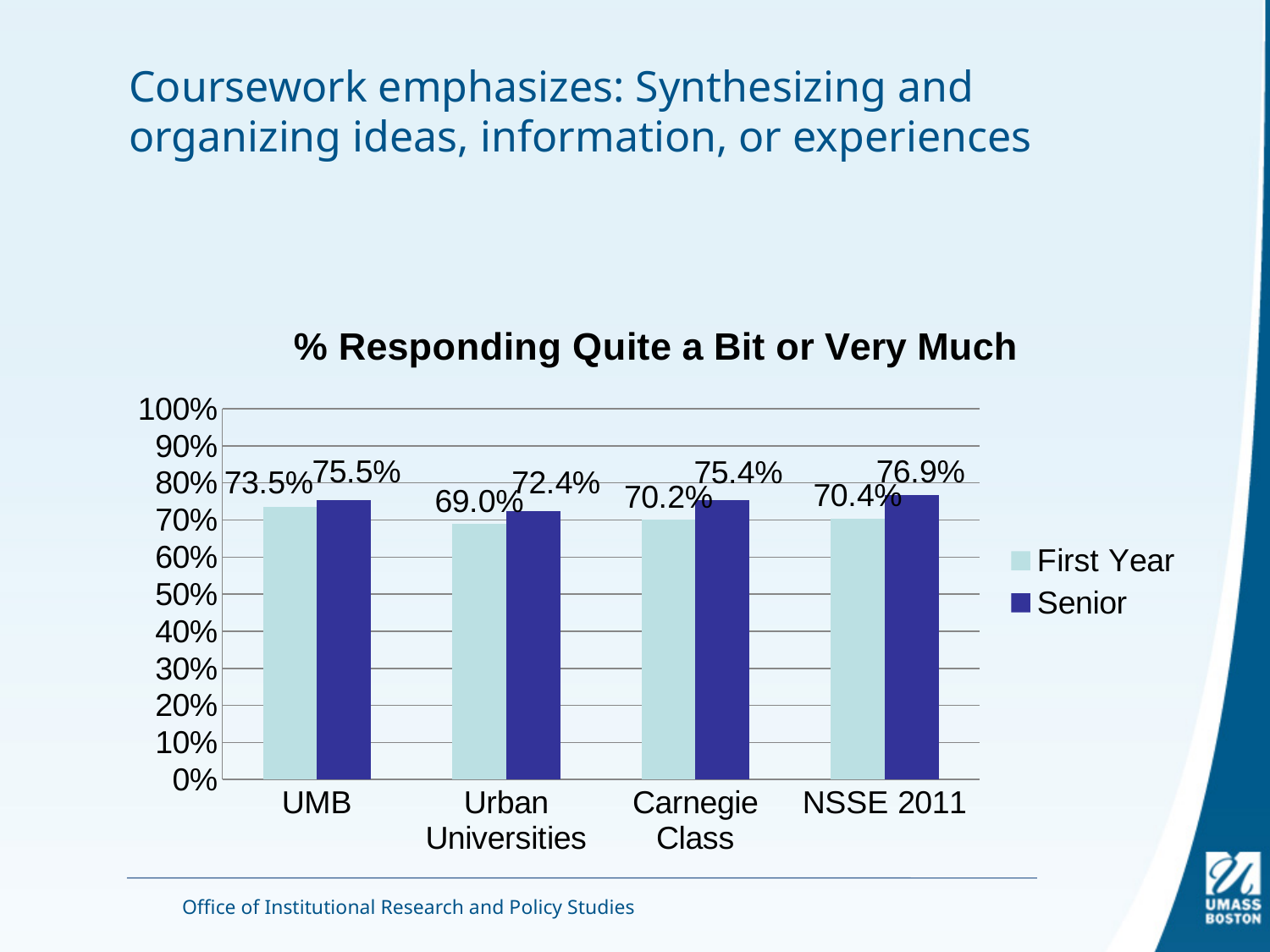
What is the Senior value for NSSE 2011? 76.9% Which is larger, the First Year value for UMB or the First Year value for Urban Universities? UMB Is the Senior value for Carnegie Class greater or less than 80%? less What is the Senior value for Urban Universities? 72.4% What is the difference between the Senior and First Year values for NSSE 2011? 6.5 percentage points How many series does the legend list? 2 What kind of chart is shown on the slide? bar chart Which category has the highest Senior value? NSSE 2011 What is the First Year value for UMB? 73.5% Which category has the lowest First Year value? Urban Universities How many categories are shown on the x axis? 4 What is the difference between the Senior and First Year values for UMB? 2.0 percentage points